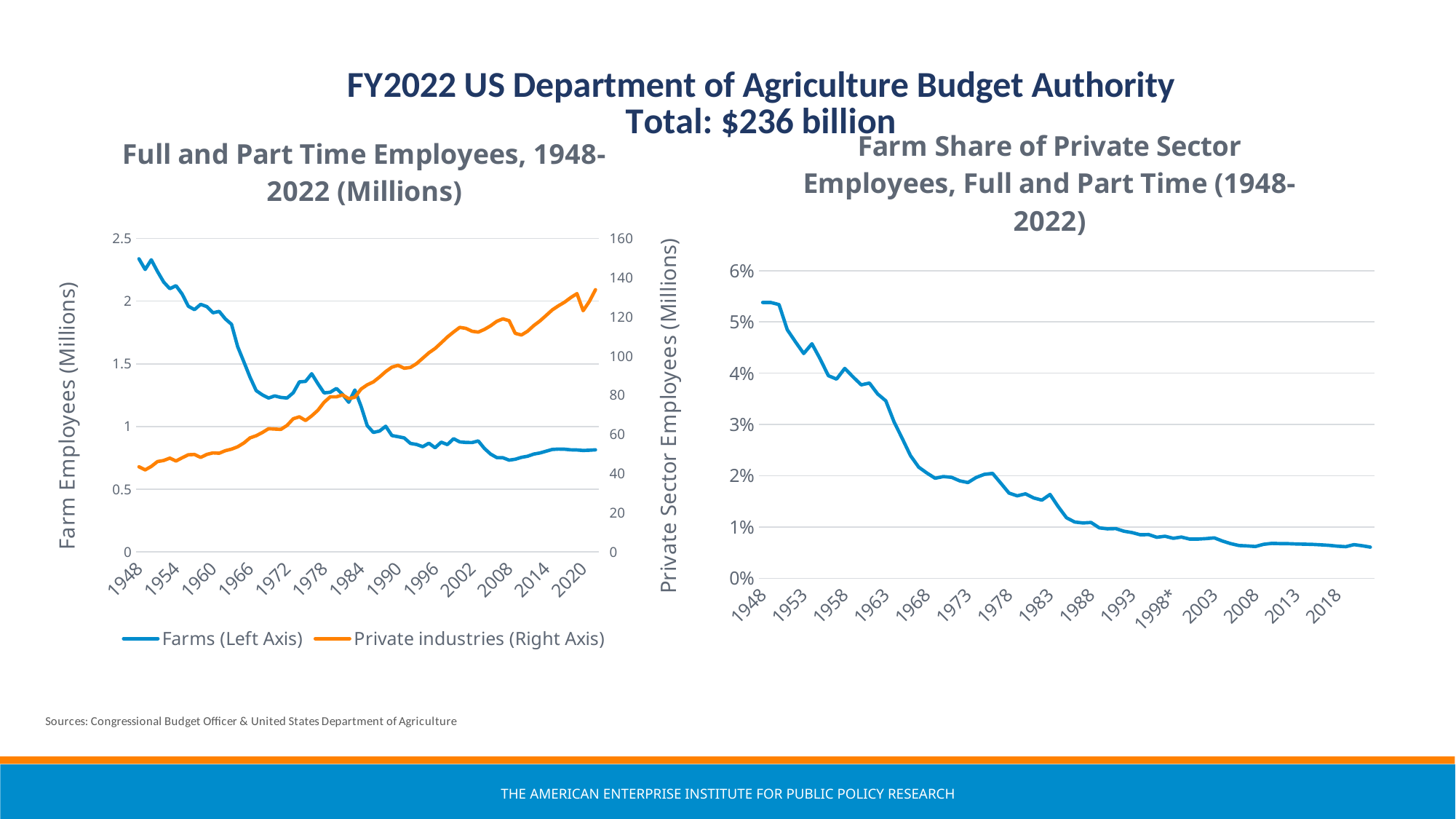
How many series does the legend of the left chart, 'Full and Part Time Employees, 1948-2022 (Millions)', list? 2 What kind of chart is the right chart, 'Farm Share of Private Sector Employees, Full and Part Time (1948-2022)'? Line chart In the right chart, 'Farm Share of Private Sector Employees, Full and Part Time (1948-2022)', is the value for 2018 greater or less than 1%? less In the right chart, 'Farm Share of Private Sector Employees, Full and Part Time (1948-2022)', is the value for 1948 greater or less than 5%? greater In the left chart, 'Full and Part Time Employees, 1948-2022 (Millions)', is the Farms value in 2020 greater or less than 1? less In the left chart, 'Full and Part Time Employees, 1948-2022 (Millions)', does the Private industries series rise or fall from 1948 to 2020? Rise In the right chart, 'Farm Share of Private Sector Employees, Full and Part Time (1948-2022)', does the farm share rise or fall over the period shown? Fall In the left chart, 'Full and Part Time Employees, 1948-2022 (Millions)', which series is plotted against the right axis according to the legend? Private industries (Right Axis) What kind of chart is the left chart, 'Full and Part Time Employees, 1948-2022 (Millions)'? Line chart In the left chart, 'Full and Part Time Employees, 1948-2022 (Millions)', does the Farms series rise or fall from 1948 to 2020? Fall